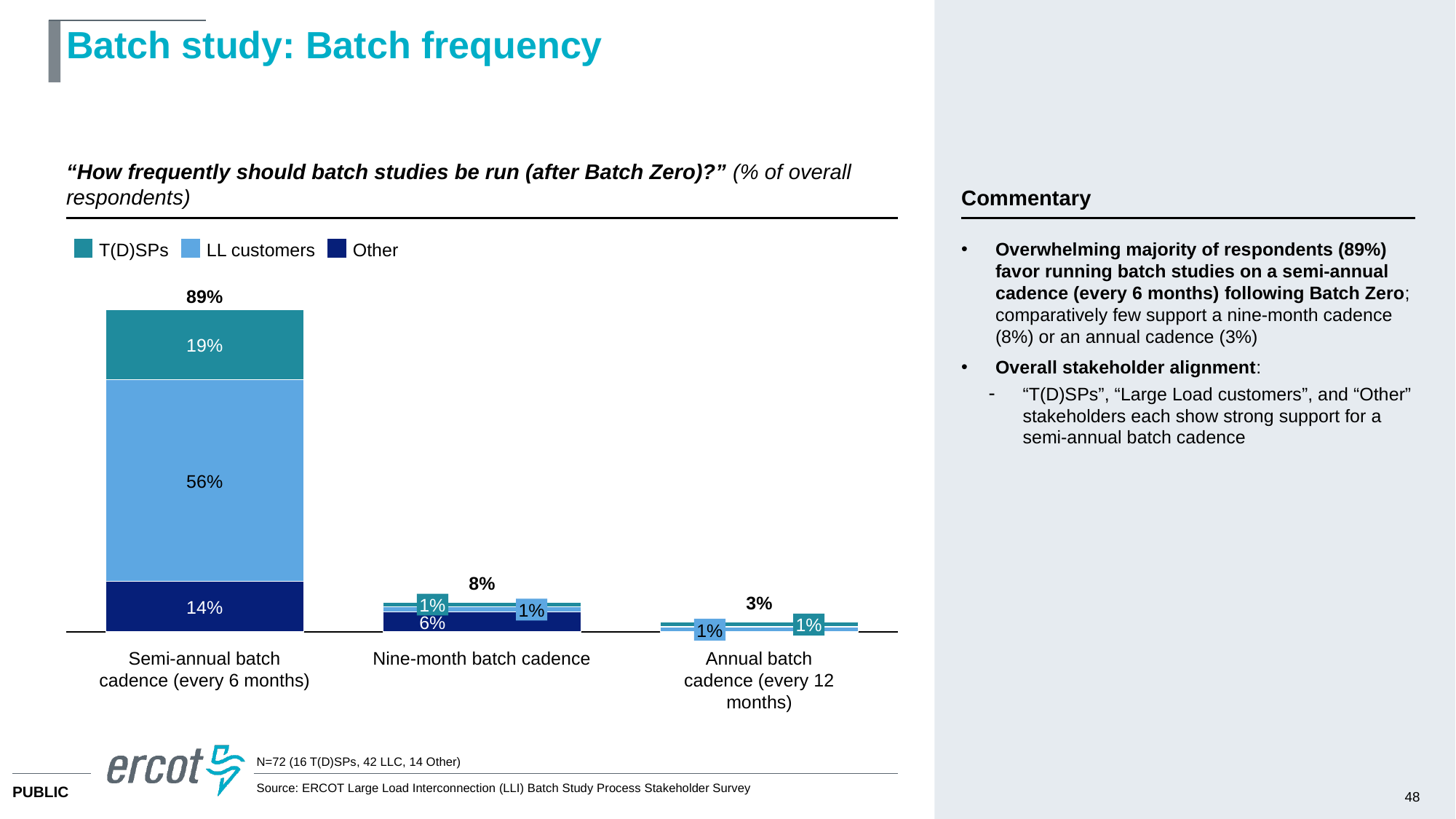
What type of chart is shown on the slide? Stacked bar chart Which series is shown in the darkest blue colour in the legend? Other How many series does the legend list? 3 What is the difference between the Semi-annual batch cadence total and the Nine-month batch cadence total? 81% What is the total for the Annual batch cadence (every 12 months) bar? 3% What is the Other value for Nine-month batch cadence? 6% What is the LL customers value for Semi-annual batch cadence (every 6 months)? 56% What is the T(D)SPs value for Semi-annual batch cadence (every 6 months)? 19% What is the total for the Semi-annual batch cadence (every 6 months) bar? 89% How many batch cadence categories are shown on the x axis? 3 Which batch cadence has the highest overall total? Semi-annual batch cadence (every 6 months) What is the total for the Nine-month batch cadence bar? 8%